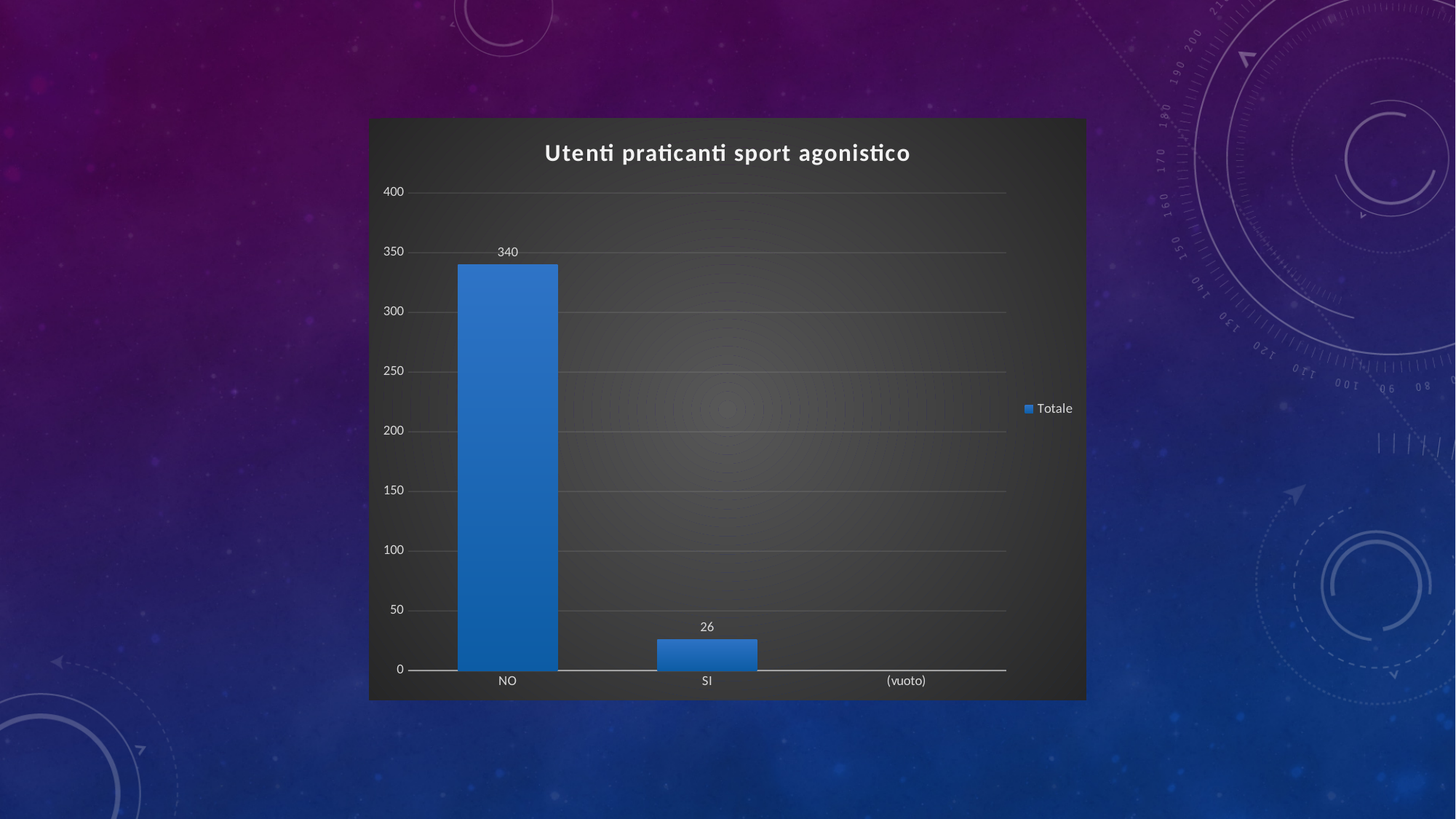
How many series does the legend list? 1 What is the title of the chart? Utenti praticanti sport agonistico Is the value for SI greater or less than 50? less Which category has the highest value? NO What kind of chart is shown? bar chart What is the difference between the values for NO and SI? 314 Which is larger, the value for NO or the value for SI? NO What is the value for SI? 26 Is the value for NO greater or less than 300? greater Which of the two labelled bars, NO or SI, has the lower value? SI How many categories are shown on the x axis? 3 What is the value for NO? 340